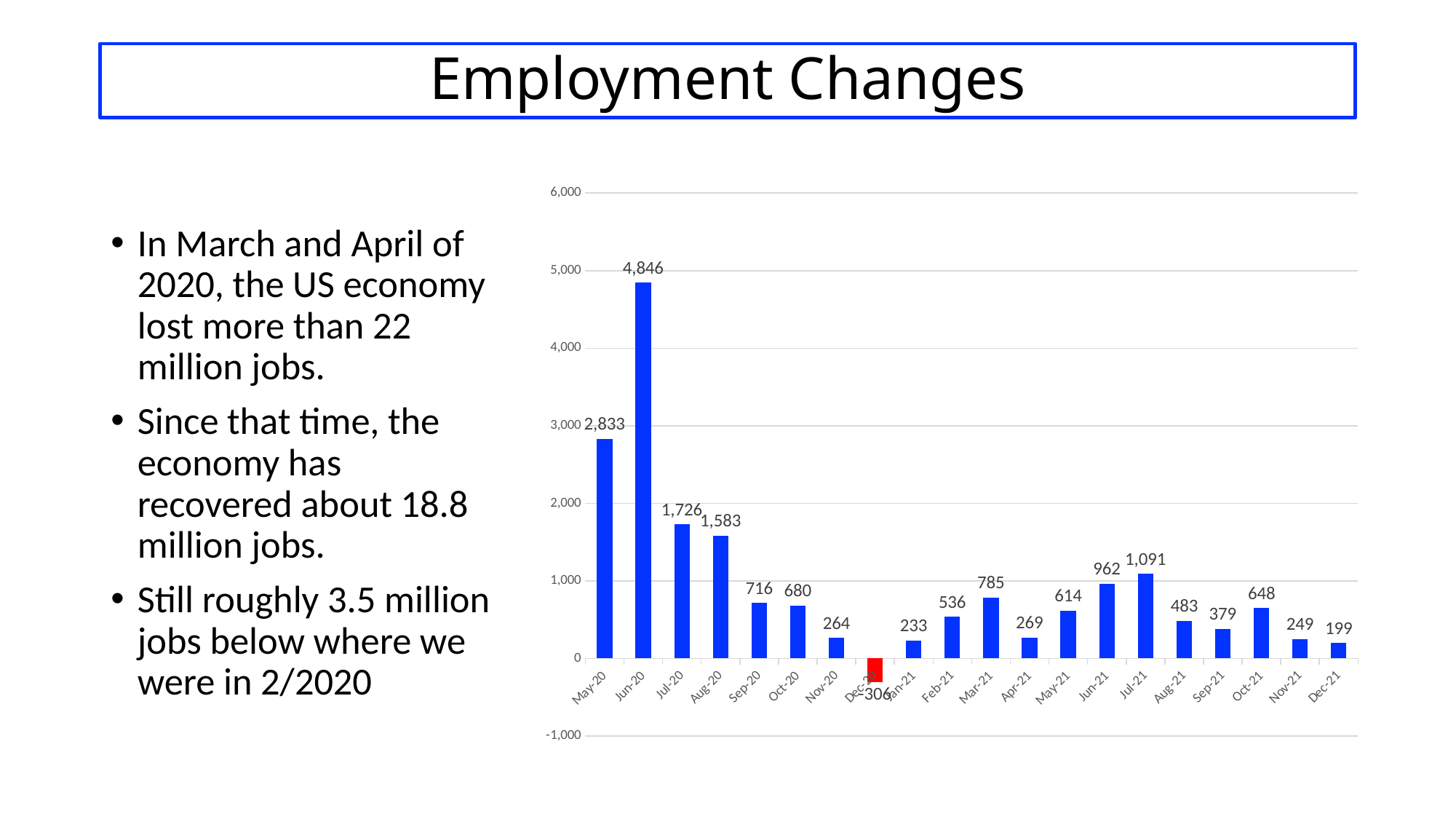
What kind of chart is shown on the slide? bar chart Which month has the highest value? Jun-20 What is the value for Jul-21? 1,091 What is the value for Dec-21? 199 What is the difference between the values for Jul-20 and Aug-20? 143 What is the difference between the values for May-20 and Jun-20? 2,013 Which is larger, the value for Mar-21 or the value for May-21? Mar-21 Is the value for Jun-21 greater or less than 1,000? less Which bar is coloured red rather than blue? Dec-20 What is the value for Jun-20? 4,846 How many months are shown on the x axis? 20 Which month has the lowest value? Dec-20